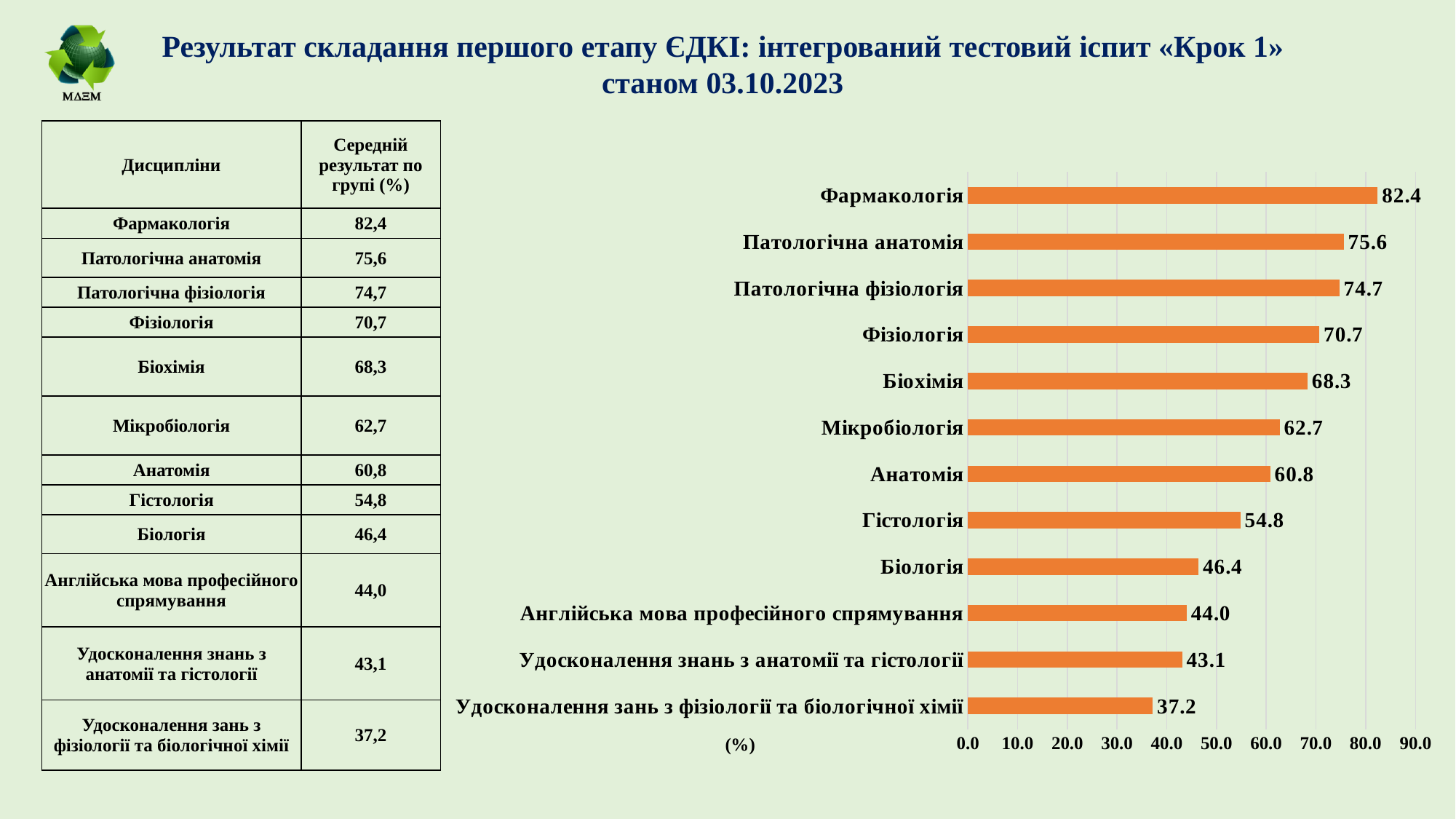
What colour are the bars in the chart? orange What is the value for Фармакологія in the bar chart? 82.4 How many categories are shown in the bar chart? 12 What kind of chart is shown on the slide? bar chart Which is larger in the bar chart: the value for Мікробіологія or the value for Анатомія? Мікробіологія What is the value for Гістологія in the bar chart? 54.8 Which category has the lowest value in the bar chart? Удосконалення зань з фізіології та біологічної хімії What is the difference between the values for Патологічна анатомія and Патологічна фізіологія in the bar chart? 0.9 Is the value for Біологія in the bar chart greater or less than 50.0? less What is the value for Англійська мова професійного спрямування in the bar chart? 44.0 Which category has the highest value in the bar chart? Фармакологія What is the difference between the values for Фармакологія and Біохімія in the bar chart? 14.1